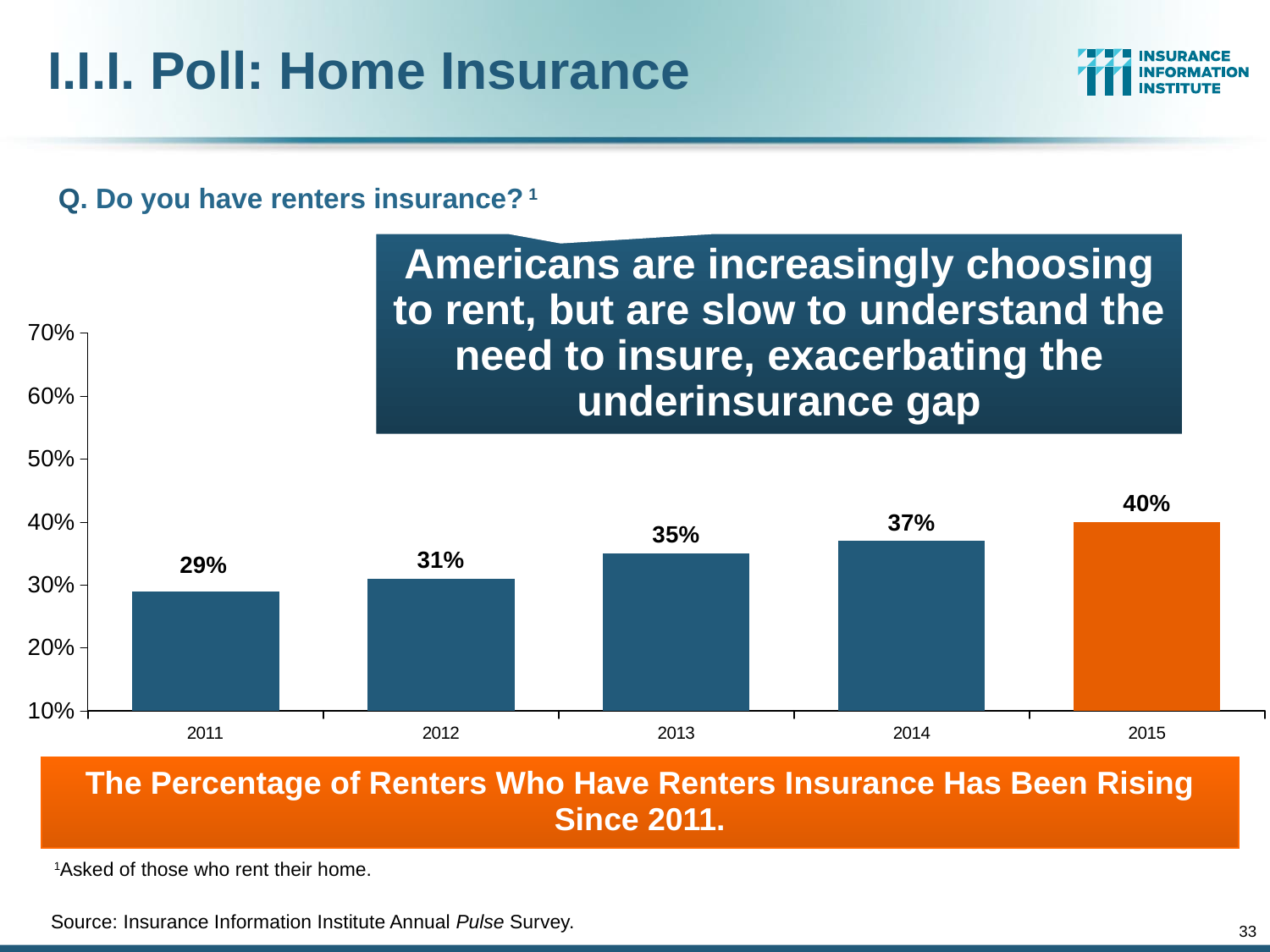
What percentage is shown for 2015? 40% Which year has the highest percentage of renters with renters insurance? 2015 Do the values rise or fall from 2011 to 2015? Rise What is the difference in percentage points between 2015 and 2011? 11 percentage points How many years are shown on the x axis of the chart? 5 What is the value shown for 2013? 35% Is the value for 2013 greater or less than 30%? greater What kind of chart is used on this slide? Bar chart Which year has the lowest percentage of renters with renters insurance? 2011 What percentage of renters had renters insurance in 2011? 29% What is the difference between the 2014 and 2012 values? 6 percentage points Which year has a higher value, 2012 or 2014? 2014